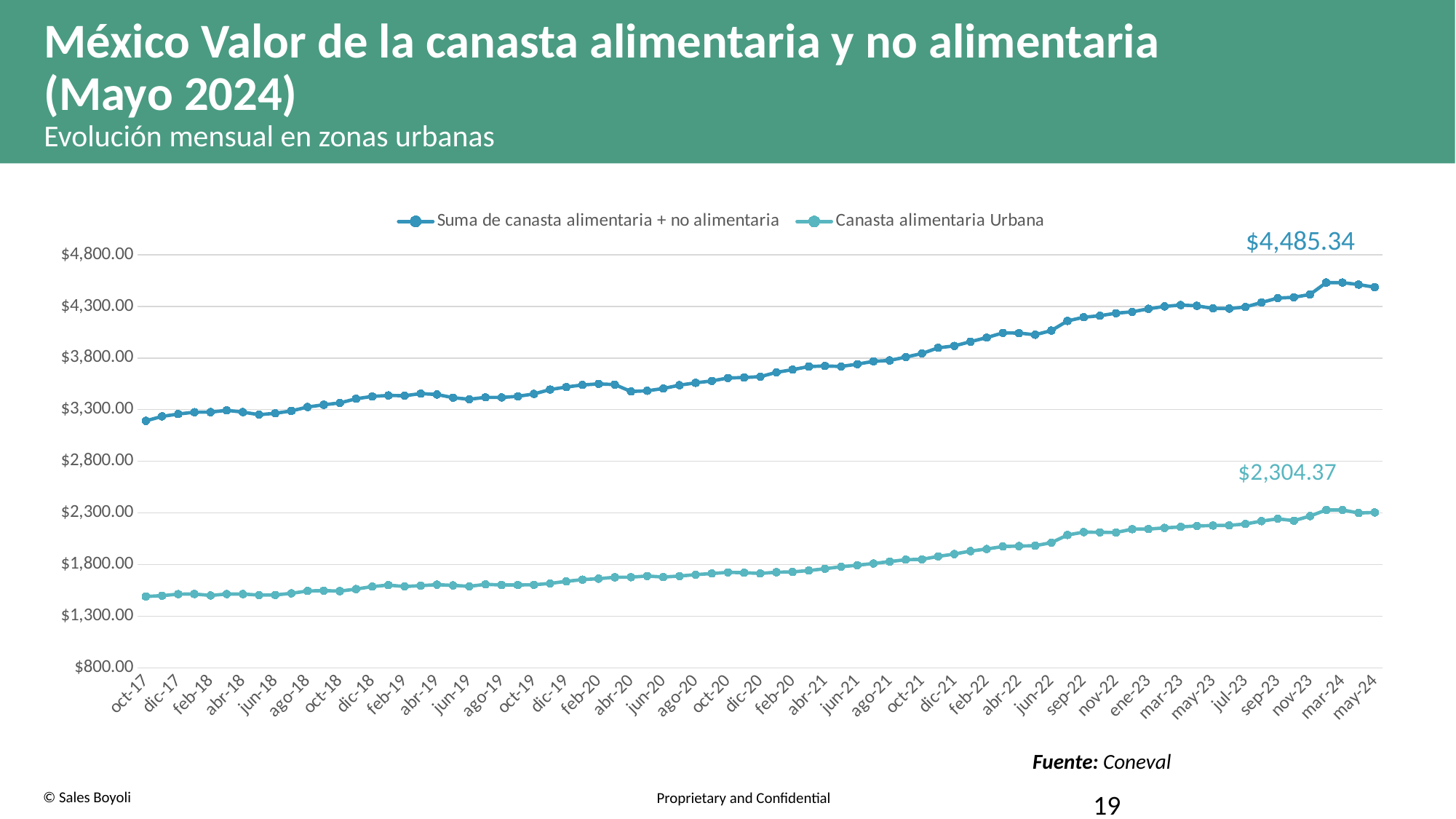
How many series does the legend list? 2 What is the subtitle of the chart slide below the main title? Evolución mensual en zonas urbanas Is the value for 'Canasta alimentaria Urbana' at oct-17 greater or less than $1,800.00? less What kind of chart is shown on the slide? line chart What is the difference between the labelled end values of 'Suma de canasta alimentaria + no alimentaria' ($4,485.34) and 'Canasta alimentaria Urbana' ($2,304.37)? $2,180.97 What is the labelled value for 'Suma de canasta alimentaria + no alimentaria' at the end of the series (may-24)? $4,485.34 Is the value for 'Suma de canasta alimentaria + no alimentaria' at oct-17 greater or less than $3,300.00? less What is the labelled value for 'Canasta alimentaria Urbana' at the end of the series (may-24)? $2,304.37 Is the value for 'Suma de canasta alimentaria + no alimentaria' at may-24 greater or less than $4,300.00? greater Which series has higher values throughout the chart, 'Suma de canasta alimentaria + no alimentaria' or 'Canasta alimentaria Urbana'? Suma de canasta alimentaria + no alimentaria What is the source cited for the chart data? Coneval Do the values of 'Canasta alimentaria Urbana' generally rise or fall from oct-17 to may-24? rise